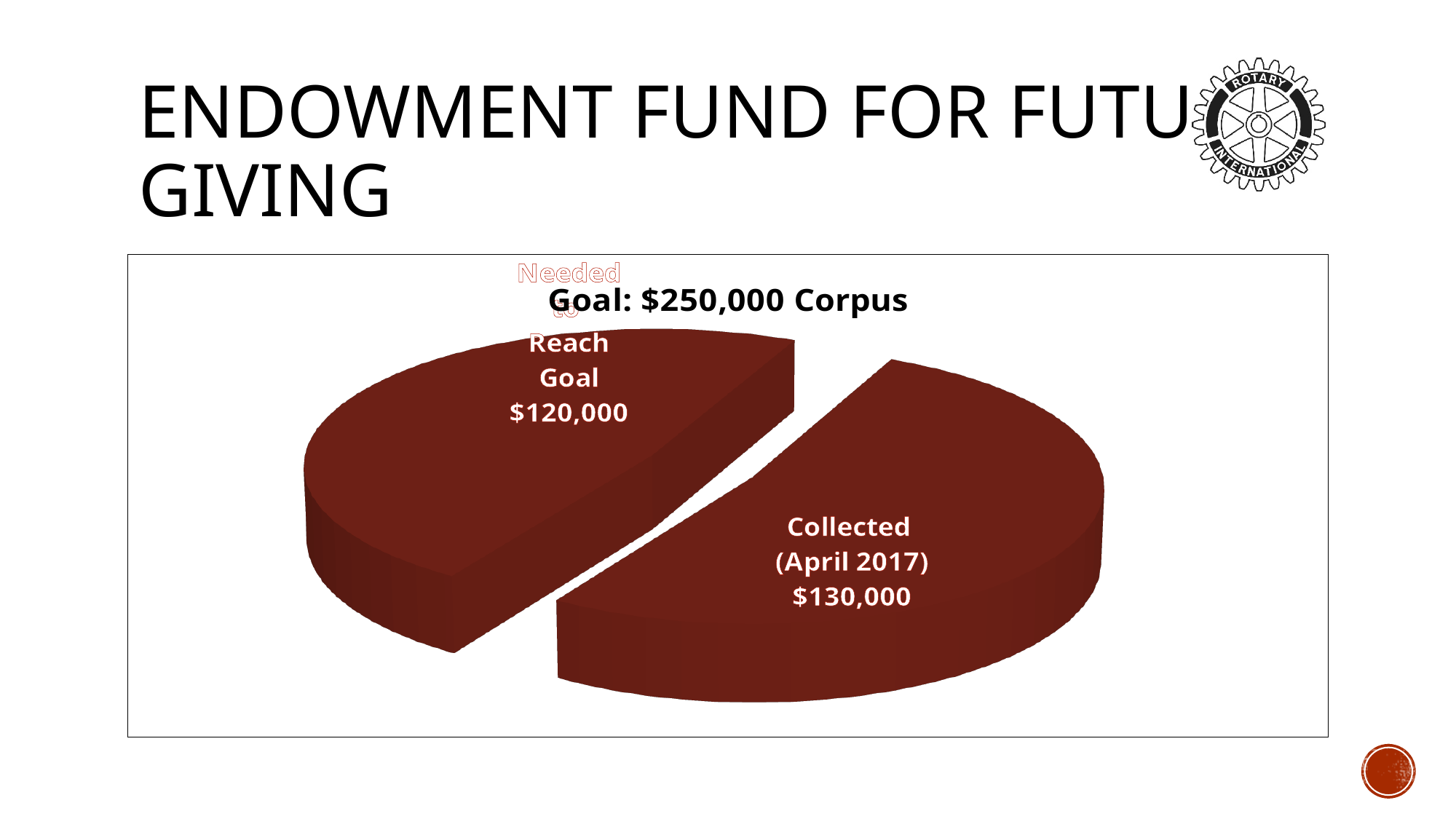
What is the title of the chart? Goal: $250,000 Corpus Which slice has the largest value? Collected (April 2017) What is the value of the Needed to Reach Goal slice? $120,000 Which slice has the smallest value? Needed to Reach Goal What is the total of the two slices in the pie chart? $250,000 Which slice is larger, Collected (April 2017) or Needed to Reach Goal? Collected (April 2017) What type of chart is shown on the slide? pie chart What is the value of the Collected (April 2017) slice? $130,000 What share of the pie does the Collected (April 2017) slice represent? 52% What share of the pie does the Needed to Reach Goal slice represent? 48% How many slices does the pie chart have? 2 What is the difference between the Collected (April 2017) value and the Needed to Reach Goal value? $10,000